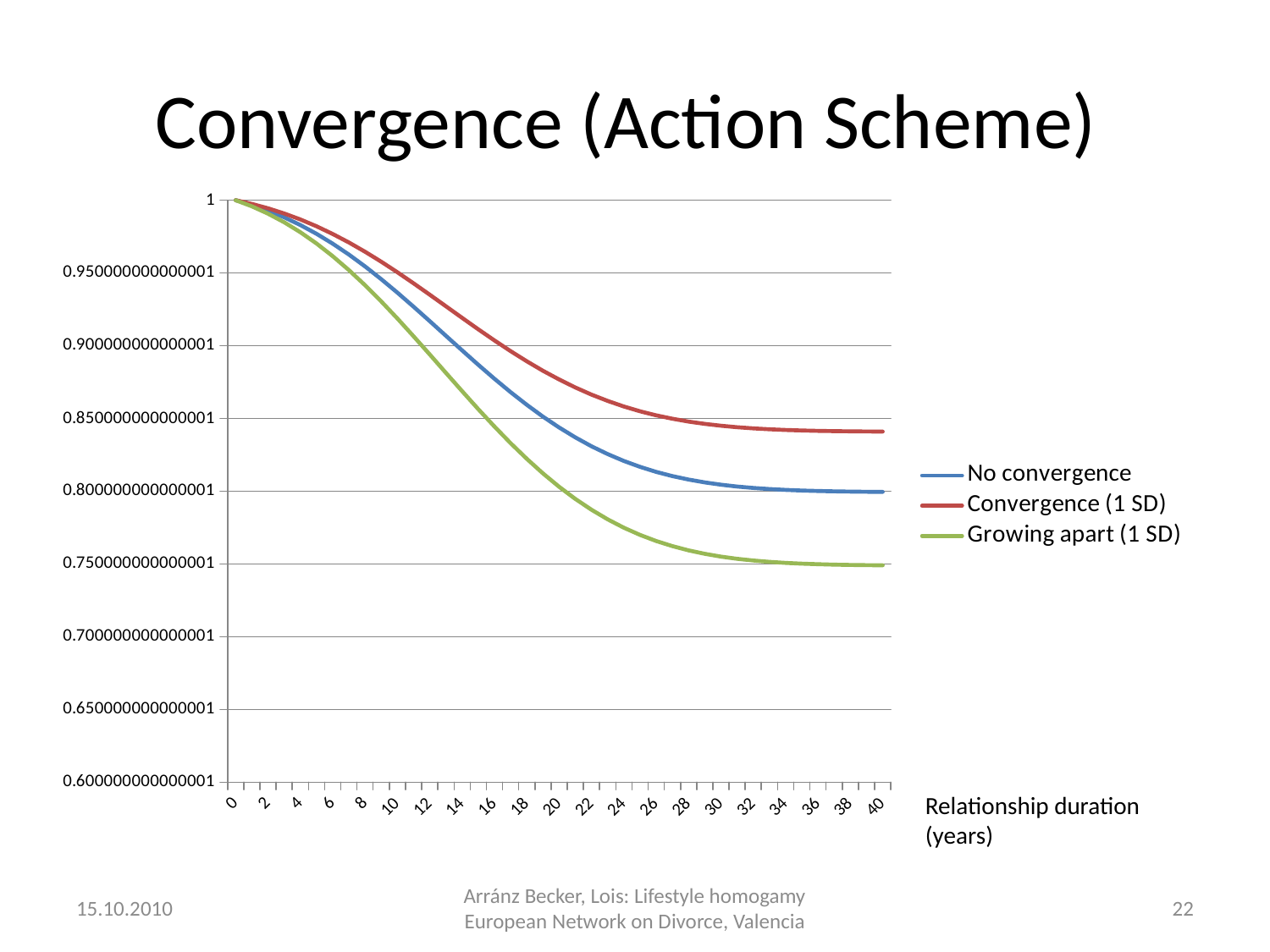
At relationship duration 30, which is larger: No convergence or Growing apart (1 SD)? No convergence How many series does the legend list? 3 Do the values of the series rise or fall as relationship duration increases? fall What is the value of the series at relationship duration 0? 1 What is the label of the x axis? Relationship duration (years) Is the value for Growing apart (1 SD) at relationship duration 40 greater or less than 0.8? less Which series has the highest value at relationship duration 40? Convergence (1 SD) What kind of chart is shown on the slide? line chart Which series has the lowest value at relationship duration 40? Growing apart (1 SD) What is the title of the chart? Convergence (Action Scheme) Is the value for Convergence (1 SD) at relationship duration 20 greater or less than 0.85? greater Is the value for Convergence (1 SD) at relationship duration 40 greater or less than 0.8? greater